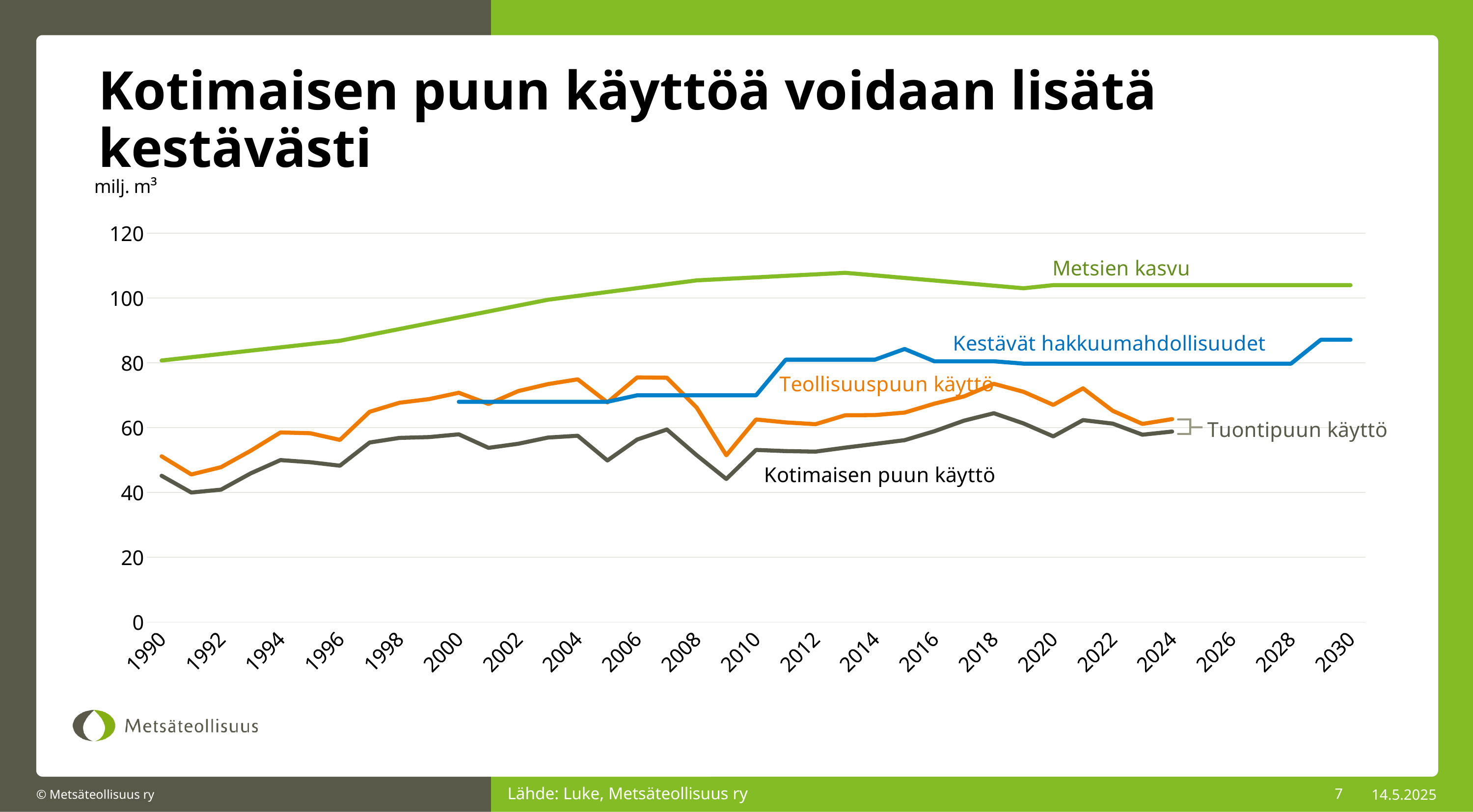
Is the value for Kestävät hakkuumahdollisuudet in 2030 greater or less than 80? greater How many data series are labelled on the chart? 4 In 2020, which is larger: Metsien kasvu or Kotimaisen puun käyttö? Metsien kasvu What colour is the Metsien kasvu line? green Which series has the highest values across the whole chart? Metsien kasvu What unit is shown on the y axis of the chart? milj. m³ Is the value for Metsien kasvu in 2014 greater or less than 100? greater Which series has the lowest values across the whole chart? Kotimaisen puun käyttö Is the value for Kotimaisen puun käyttö in 1990 greater or less than 60? less What kind of chart is shown on the slide? line chart Does the Metsien kasvu line rise or fall between 1990 and 2014? rise